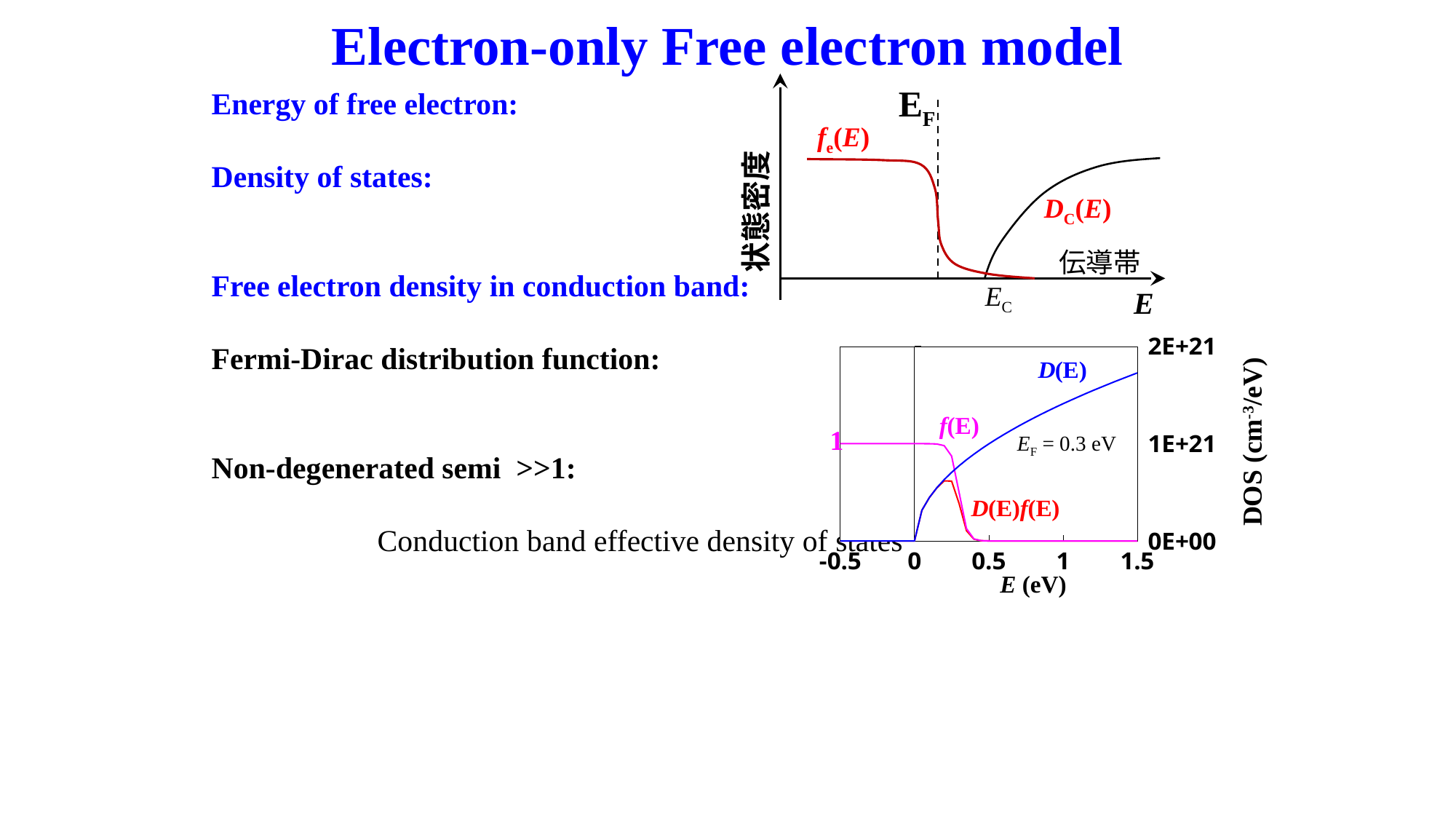
In the lower chart, what is the label of the right-hand y axis? DOS (cm-3/eV) In the lower chart, is the value of D(E) at E = 1.5 eV greater or less than 1E+21? greater In the lower chart, does the D(E) curve rise or fall as E increases from 0 to 1.5 eV? rise In the lower chart, what is the lowest tick value shown on the E (eV) axis? -0.5 In the lower chart, how many curves are plotted and labelled? 3 In the lower chart, is the value of D(E) at E = 1 eV greater or less than 1E+21? greater In the upper chart, how many curves are drawn? 2 In the lower chart, what is the highest tick value shown on the DOS axis? 2E+21 In the lower chart, what is the label of the x axis? E (eV) In the lower chart, what value of E_F is annotated? 0.3 eV In the lower chart, does the f(E) curve rise or fall as E increases? fall What kind of chart is the lower chart with the E (eV) axis? line chart